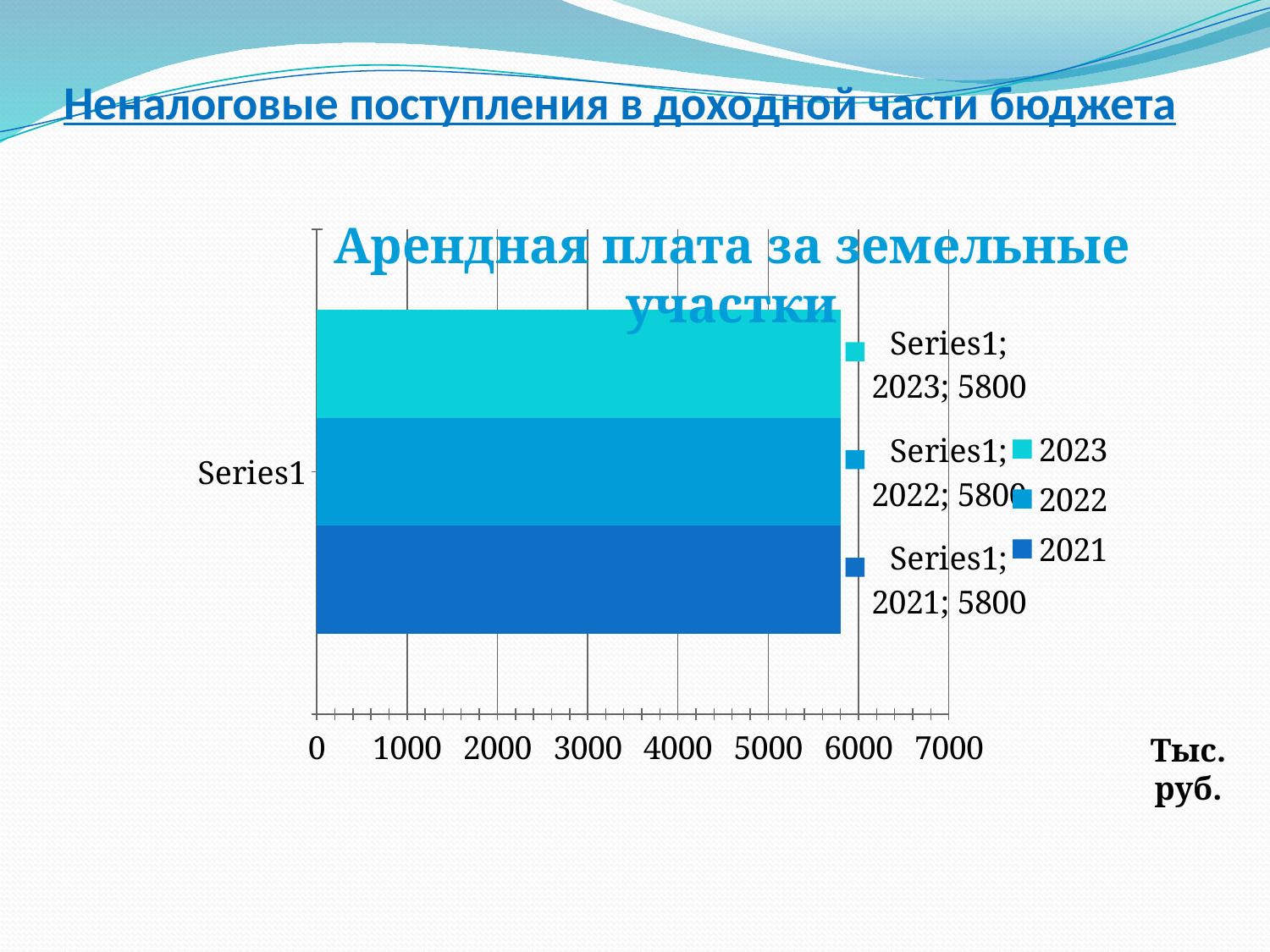
What is the value for 2022 in the chart? 5800 What is the highest tick value shown on the horizontal axis? 7000 Are the values for 2022 and 2023 equal, or is one larger? equal Is the value for 2023 greater or less than 6000? less What kind of chart is shown on the slide? bar chart What is the difference between the values for 2023 and 2021? 0 How many series does the legend list? 3 Is the value for 2021 greater or less than 5000? greater What is the title of the chart? Арендная плата за земельные участки What is the value for 2023 in the chart? 5800 What unit is indicated next to the horizontal axis? Тыс. руб. What is the value for 2021 in the chart? 5800